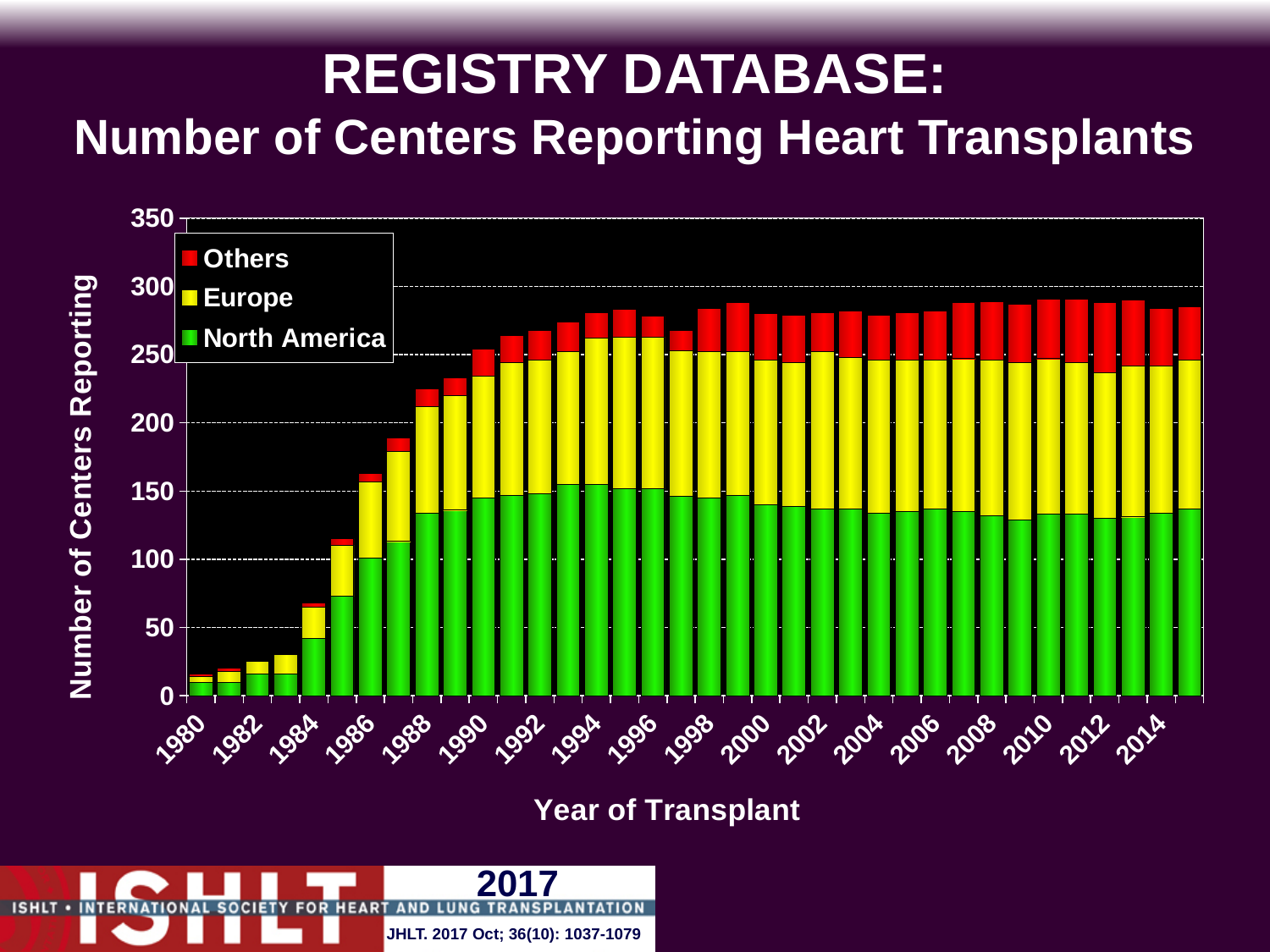
Is the number of North America centers reporting in 1995 greater or less than 100? greater Does the total number of centers reporting rise or fall from 1980 to 1990? rise Is the total number of centers reporting in 2000 greater or less than 250? greater Is the total number of centers reporting in 1987 greater or less than 150? greater What kind of chart is shown on the slide? Stacked bar chart Which series is shown in green in the legend? North America How many series does the legend list? 3 Which year has more North America centers reporting, 1985 or 1995? 1995 What is the title of the vertical axis? Number of Centers Reporting Which year has the lowest total number of centers reporting? 1980 Which year has a larger total number of centers reporting, 1980 or 2000? 2000